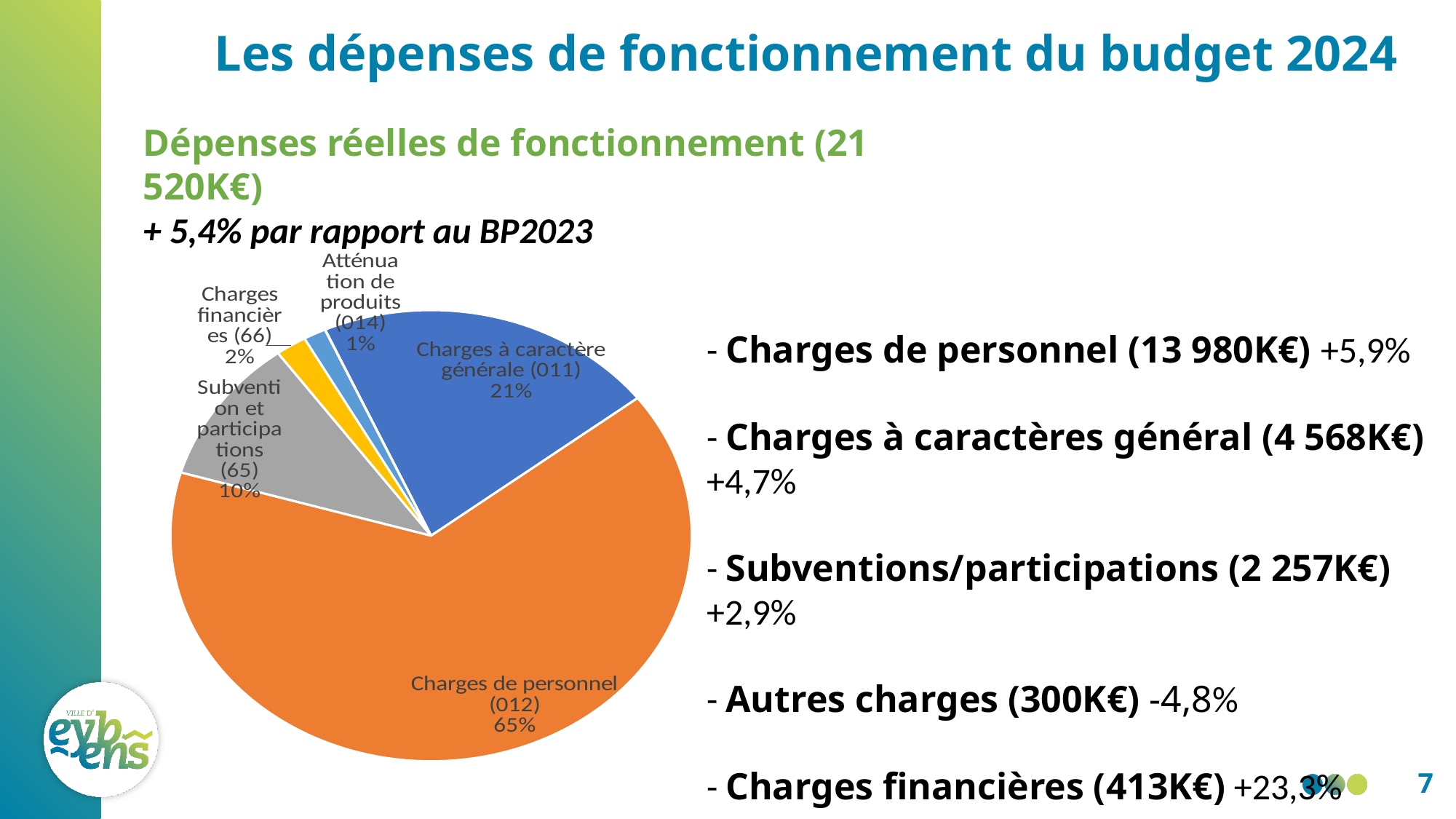
What percentage is shown for Charges financières (66)? 2% Which category has the largest slice of the pie? Charges de personnel (012) How many slices does the pie chart have? 5 Which category has the smallest slice of the pie? Atténuation de produits (014) What percentage is shown for Subvention et participations (65)? 10% What percentage is shown for Atténuation de produits (014)? 1% What is the difference in percentage points between Charges de personnel (012) and Charges à caractère générale (011)? 44 What share of the pie does Charges à caractère générale (011) represent? 21% Which is larger: Subvention et participations (65) or Charges financières (66)? Subvention et participations (65) What colour is the Charges de personnel (012) slice? orange What share of the pie does Charges de personnel (012) represent? 65% What kind of chart is shown on the slide? pie chart